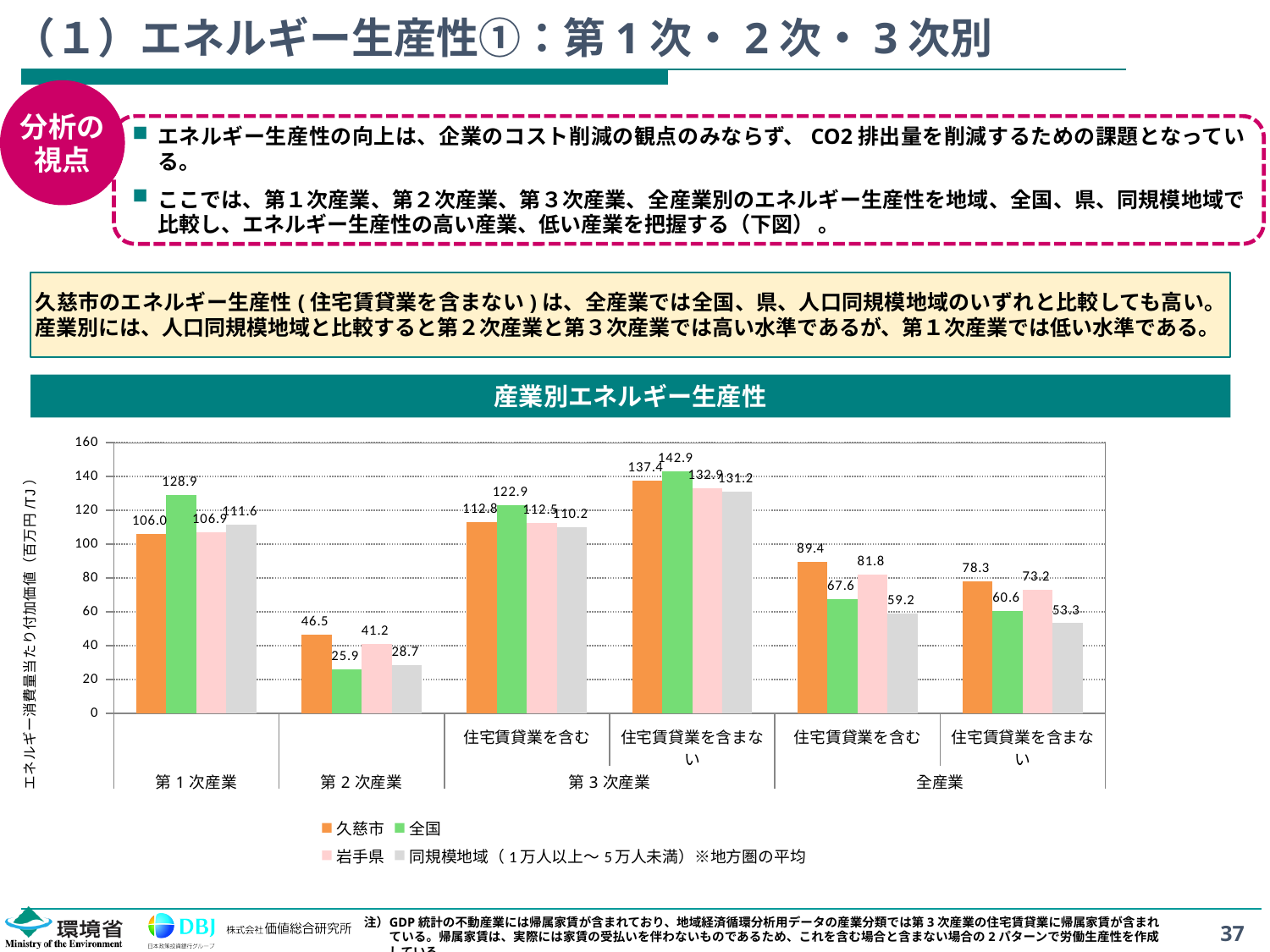
Which is larger in 全産業 (住宅賃貸業を含む): 久慈市 or 岩手県? 久慈市 What is the value for 同規模地域 in 全産業 (住宅賃貸業を含む)? 59.2 What is the y-axis label of the chart? エネルギー消費量当たり付加価値（百万円/TJ） What type of chart is shown under the title 産業別エネルギー生産性? bar chart What is the difference between 久慈市 and 同規模地域 in 第2次産業? 17.8 How many category groups of bars are shown along the x axis? 6 How many series does the legend list? 4 What is the value for 岩手県 in 第3次産業 (住宅賃貸業を含まない)? 132.9 What is the value for 全国 in 第2次産業? 25.9 What is the value for 久慈市 in 第1次産業? 106.0 Which series has the highest value in 第1次産業? 全国 Which series has the lowest value in 全産業 (住宅賃貸業を含まない)? 同規模地域